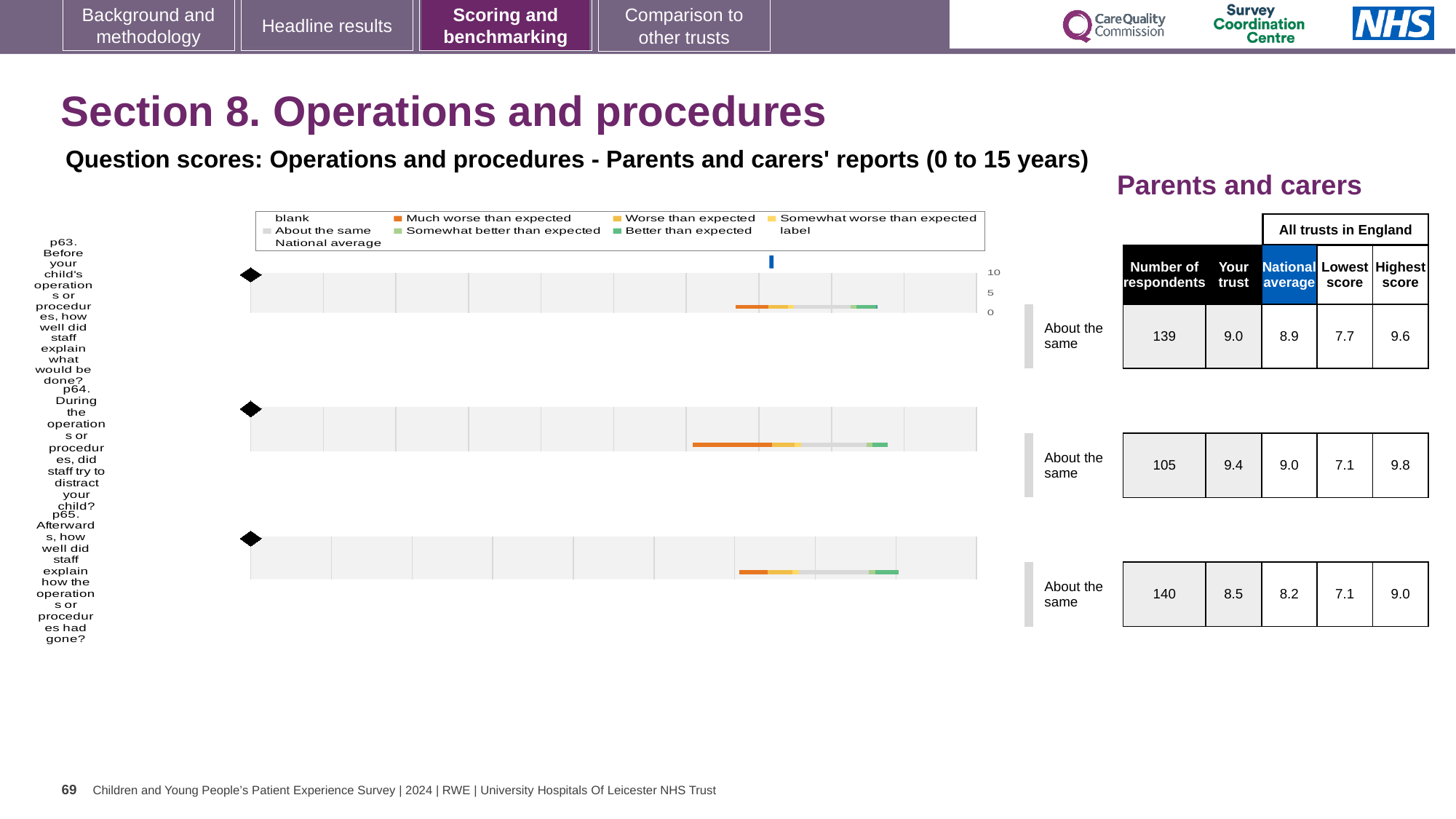
What is the highest score among all trusts in England for p64? 9.8 Which question has the lowest 'Your trust' score? p65 How many question charts are shown on the slide? 3 Which question has the highest 'Your trust' score? p64 Which has the larger 'Your trust' score, p63 or p64? p64 What colour represents 'Much worse than expected' in the legend? orange How many respondents answered p65 (Afterwards, how well did staff explain how the operations or procedures had gone?)? 140 What kind of chart is used for each question row? bar chart What is the difference between the 'Your trust' score and the national average for p65? 0.3 What is the 'Your trust' score for p64 (During the operations or procedures, did staff try to distract your child?)? 9.4 What benchmark category is shown for p63? About the same What is the national average score for p63 (Before your child's operations or procedures, how well did staff explain what would be done?)? 8.9